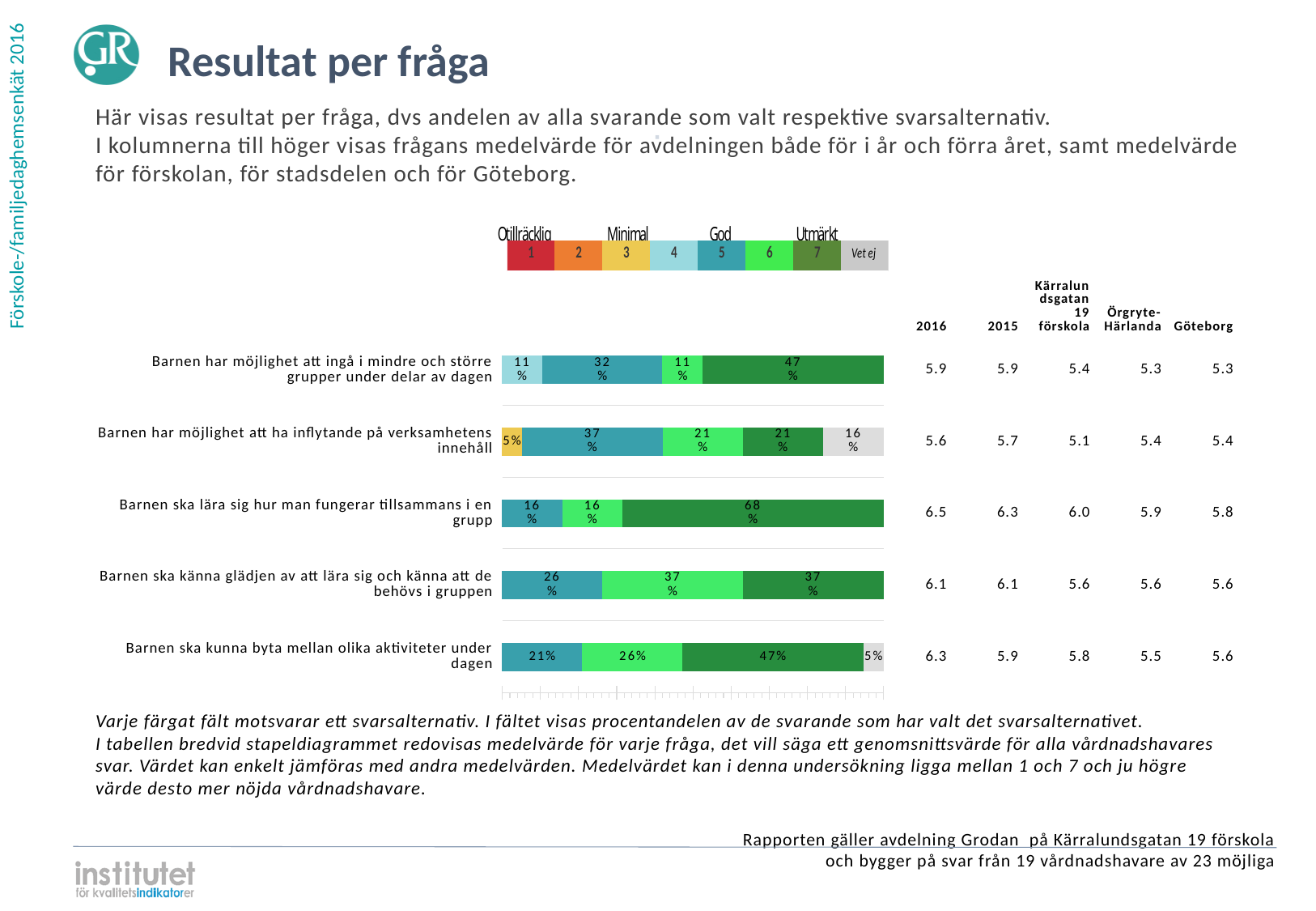
How many questions (categories) are plotted in the bar chart? 5 How many entries does the chart legend list? 8 What percentage chose answer 5 for 'Barnen ska kunna byta mellan olika aktiviteter under dagen'? 21% What kind of chart is shown on the slide? Stacked bar chart What label does the legend give to the grey answer category? Vet ej Which question has the largest share of respondents choosing answer 7 (dark green)? Barnen ska lära sig hur man fungerar tillsammans i en grupp For 'Barnen ska känna glädjen av att lära sig och känna att de behövs i gruppen', which is larger: the share for answer 5 or the share for answer 6? Answer 6 What percentage of respondents chose answer 7 (dark green) for 'Barnen ska lära sig hur man fungerar tillsammans i en grupp'? 68% What percentage chose 'Vet ej' for 'Barnen har möjlighet att ha inflytande på verksamhetens innehåll'? 16% What is the combined share of answers 6 and 7 for 'Barnen ska känna glädjen av att lära sig och känna att de behövs i gruppen'? 74% What is the difference between the answer 7 share for 'Barnen ska kunna byta mellan olika aktiviteter under dagen' and for 'Barnen har möjlighet att ha inflytande på verksamhetens innehåll'? 26% What percentage chose answer 3 (yellow) for 'Barnen har möjlighet att ha inflytande på verksamhetens innehåll'? 5%